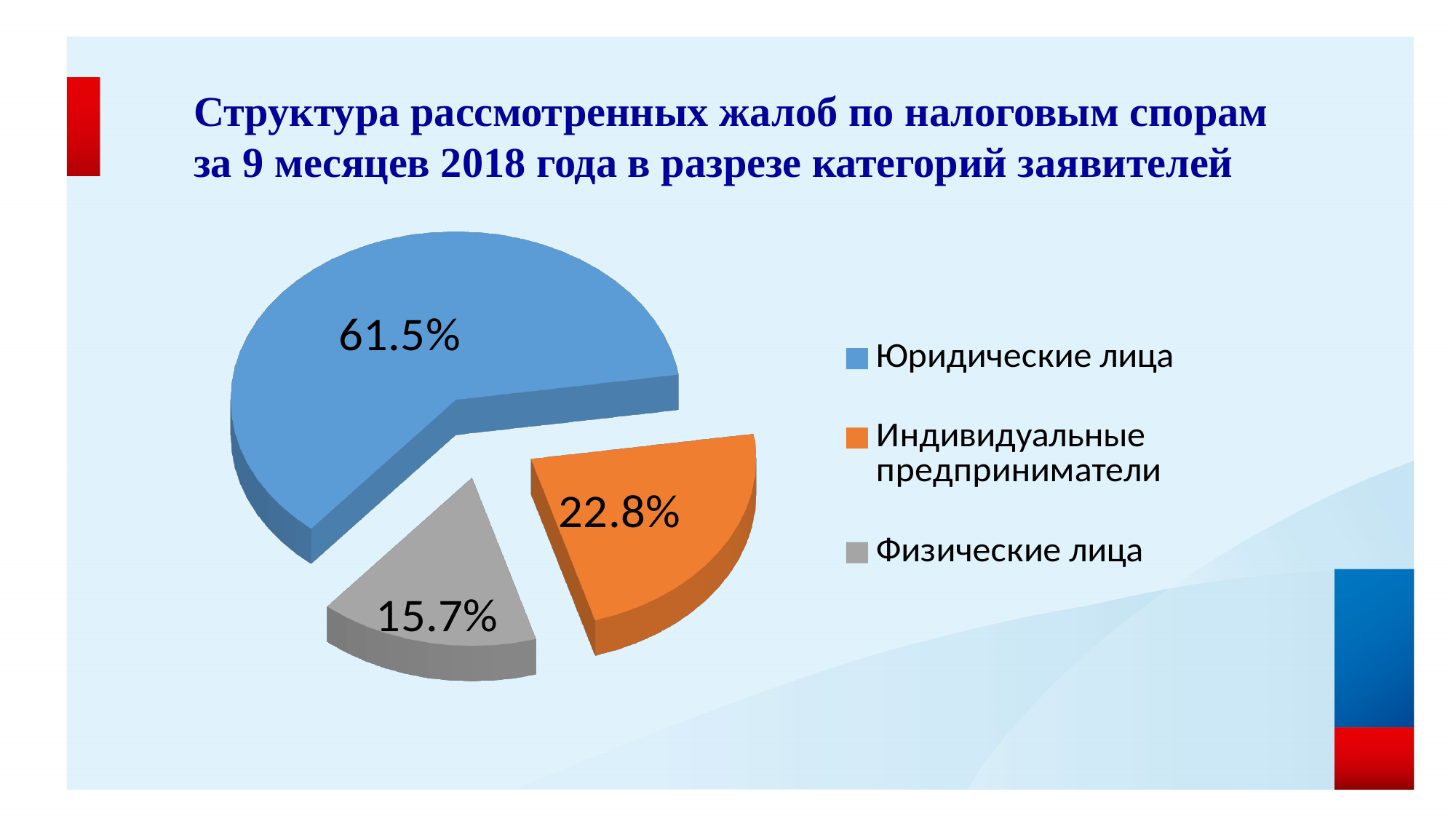
Which category has the largest slice of the pie? Юридические лица Which slice is larger: Индивидуальные предприниматели or Физические лица? Индивидуальные предприниматели What is the difference in percentage points between the Индивидуальные предприниматели slice and the Физические лица slice? 7.1 What colour is the slice for Физические лица? Grey What is the title of the chart on the slide? Структура рассмотренных жалоб по налоговым спорам за 9 месяцев 2018 года в разрезе категорий заявителей How many slices does the pie chart have? 3 Which category has the smallest slice of the pie? Физические лица What kind of chart is shown on the slide? Pie chart What share of the pie is labelled for Физические лица? 15.7% What is the difference in percentage points between the Юридические лица slice and the Индивидуальные предприниматели slice? 38.7 What share of the pie is labelled for Юридические лица? 61.5% What share of the pie is labelled for Индивидуальные предприниматели? 22.8%